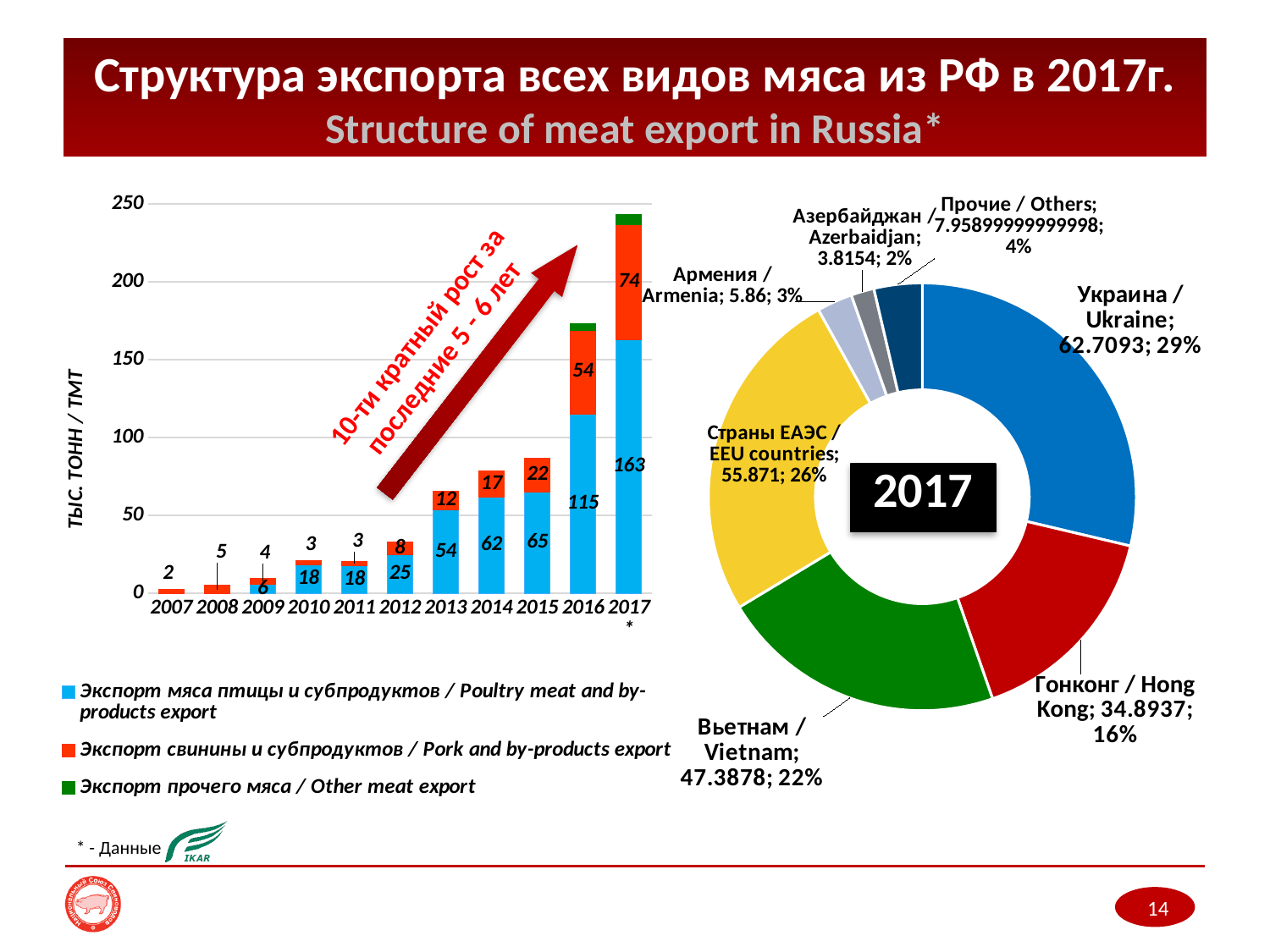
In the bar chart on the left, how many years are shown on the x axis? 11 What kind of chart is the chart on the left of the slide? Stacked bar chart In the doughnut chart on the right, which destination has the largest share? Ukraine In the doughnut chart on the right, what share of meat export goes to Vietnam? 22% In the bar chart on the left, does poultry meat export rise or fall from 2012 to 2017? Rise In the doughnut chart on the right, which is larger: Hong Kong or EEU countries? EEU countries In the bar chart on the left, what is the value of poultry meat and by-products export for 2017? 163 In the bar chart on the left, what is the difference between poultry meat export in 2017 and in 2016? 48 In the bar chart on the left, how many series does the legend list? 3 In the doughnut chart on the right, what is the value for Ukraine? 62.7093 In the bar chart on the left, is the total height of the 2017 bar greater or less than 200? greater In the bar chart on the left, what is the value of pork and by-products export for 2016? 54